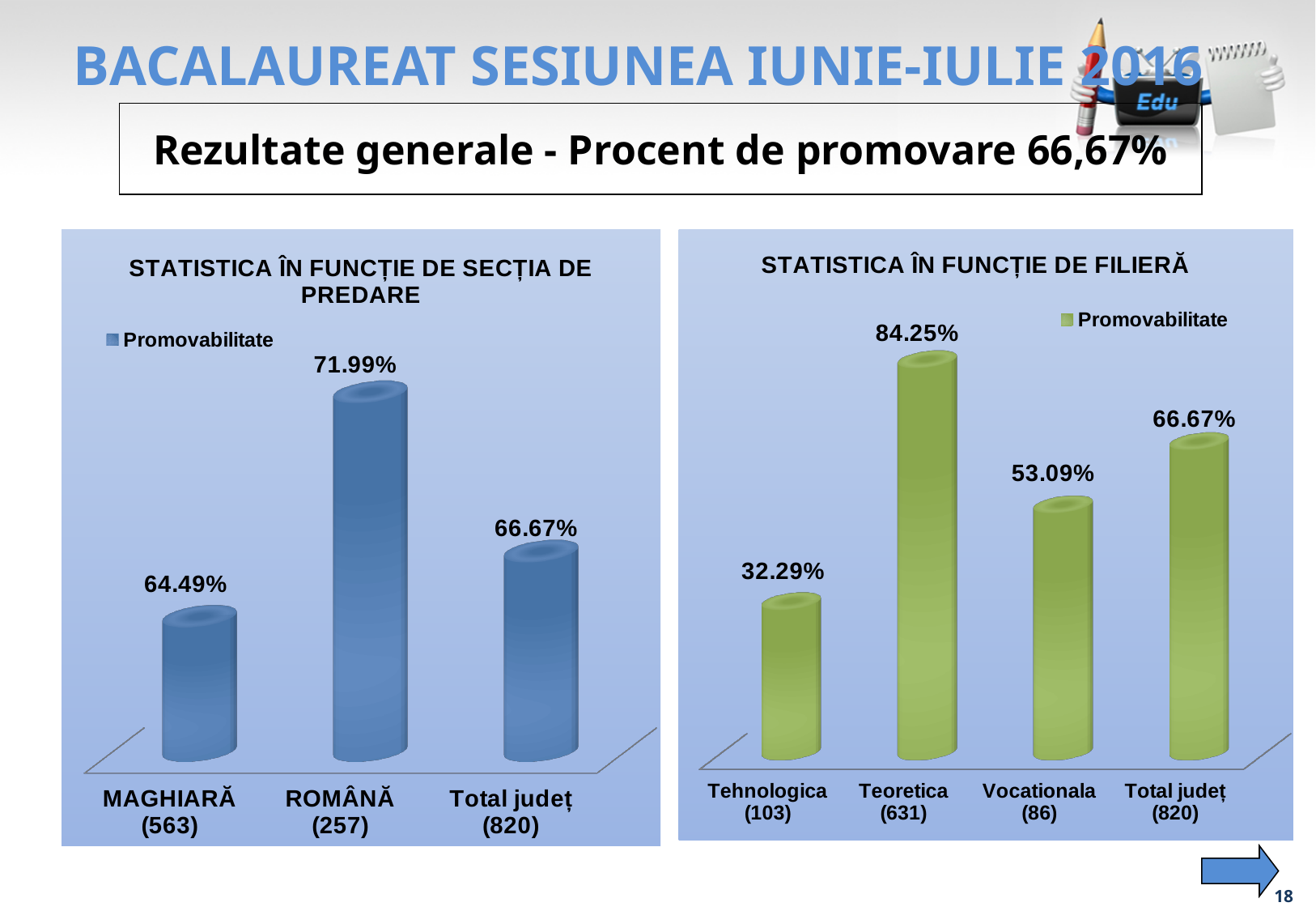
In the chart titled 'STATISTICA ÎN FUNCȚIE DE SECȚIA DE PREDARE', what is the difference between the values for ROMÂNĂ and MAGHIARĂ? 7.50% In the chart titled 'STATISTICA ÎN FUNCȚIE DE FILIERĂ', how many categories are shown? 4 In the chart titled 'STATISTICA ÎN FUNCȚIE DE FILIERĂ', what is the difference between the values for Teoretica and Tehnologica? 51.96% In the chart titled 'STATISTICA ÎN FUNCȚIE DE FILIERĂ', which category has the lowest value? Tehnologica In the chart titled 'STATISTICA ÎN FUNCȚIE DE SECȚIA DE PREDARE', what is the value for MAGHIARĂ? 64.49% In the chart titled 'STATISTICA ÎN FUNCȚIE DE SECȚIA DE PREDARE', how many categories are shown? 3 In the chart titled 'STATISTICA ÎN FUNCȚIE DE FILIERĂ', which is larger, the value for Vocationala or the value for Total județ? Total județ What kind of chart is the chart titled 'STATISTICA ÎN FUNCȚIE DE FILIERĂ'? Bar chart In the chart titled 'STATISTICA ÎN FUNCȚIE DE FILIERĂ', what is the value for Vocationala? 53.09% In the chart titled 'STATISTICA ÎN FUNCȚIE DE SECȚIA DE PREDARE', which category has the highest value? ROMÂNĂ In the chart titled 'STATISTICA ÎN FUNCȚIE DE FILIERĂ', what is the value for Teoretica? 84.25% In the chart titled 'STATISTICA ÎN FUNCȚIE DE SECȚIA DE PREDARE', what is the value for ROMÂNĂ? 71.99%